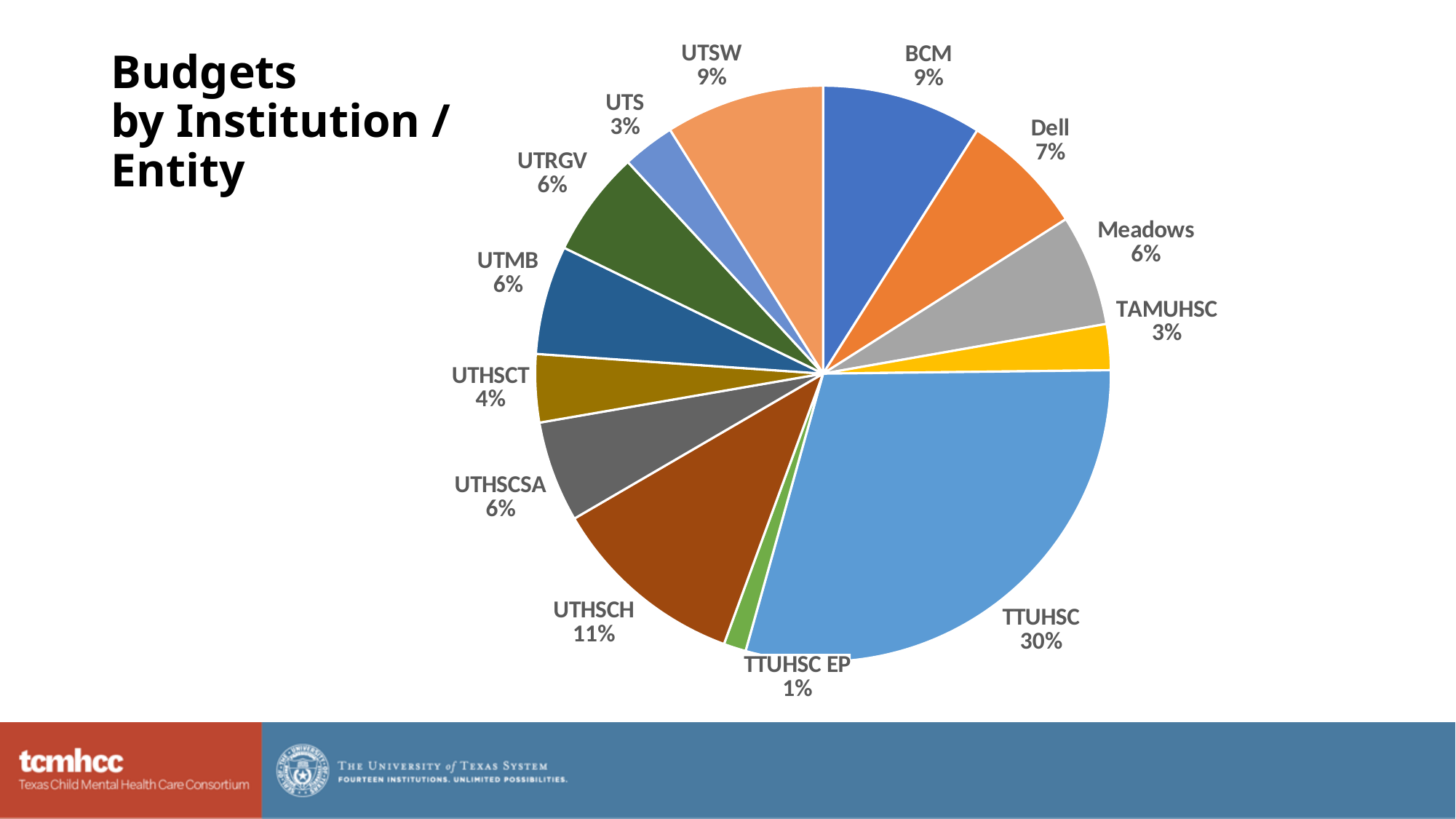
What percentage is shown for UTHSCT? 4% How many slices does the pie chart have? 13 What is the combined share of UTS and TAMUHSC? 6% What is the difference in percentage points between TTUHSC and UTHSCH? 19 Which institution has the smallest share of the budget? TTUHSC EP What is the title of the chart? Budgets by Institution / Entity What percentage is shown for UTHSCH? 11% What share of the budget does TTUHSC have? 30% What kind of chart is shown on the slide? Pie chart Which has a larger share, BCM or Dell? BCM Which institution has the largest share of the budget? TTUHSC What percentage is shown for Dell? 7%